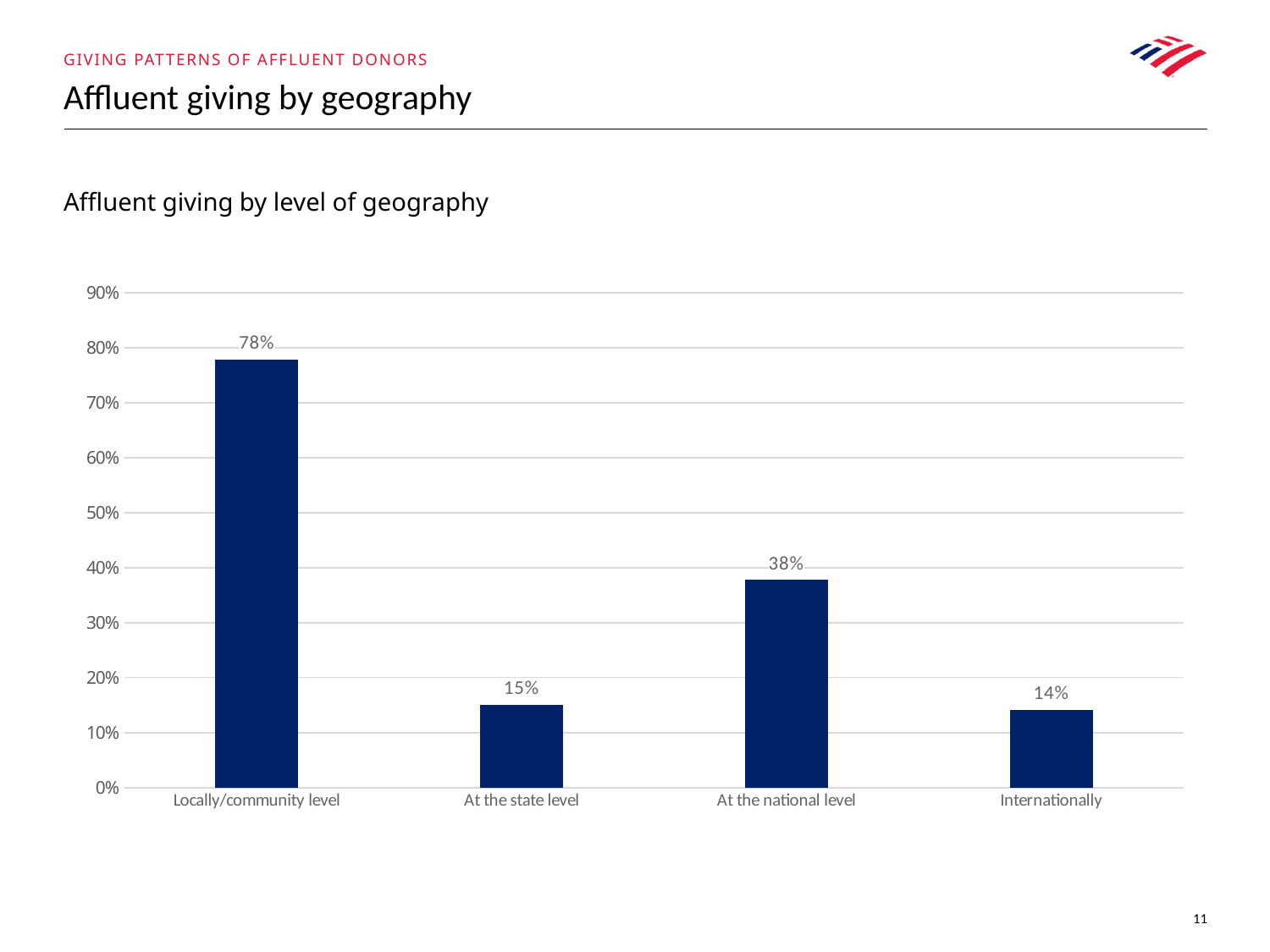
What is the value for giving internationally? 14% Which is larger: the value at the national level or at the state level? At the national level What is the title of the chart? Affluent giving by level of geography What is the difference between the locally/community level value and the national level value? 40 percentage points Which level of geography has the lowest share of affluent giving? Internationally Is the value for the national level greater or less than 40%? less What type of chart is shown on the slide? Bar chart What is the value for giving at the national level? 38% What is the value for giving at the state level? 15% How many levels of geography are shown on the chart? 4 Which level of geography has the highest share of affluent giving? Locally/community level What percentage of affluent donors give at the locally/community level? 78%